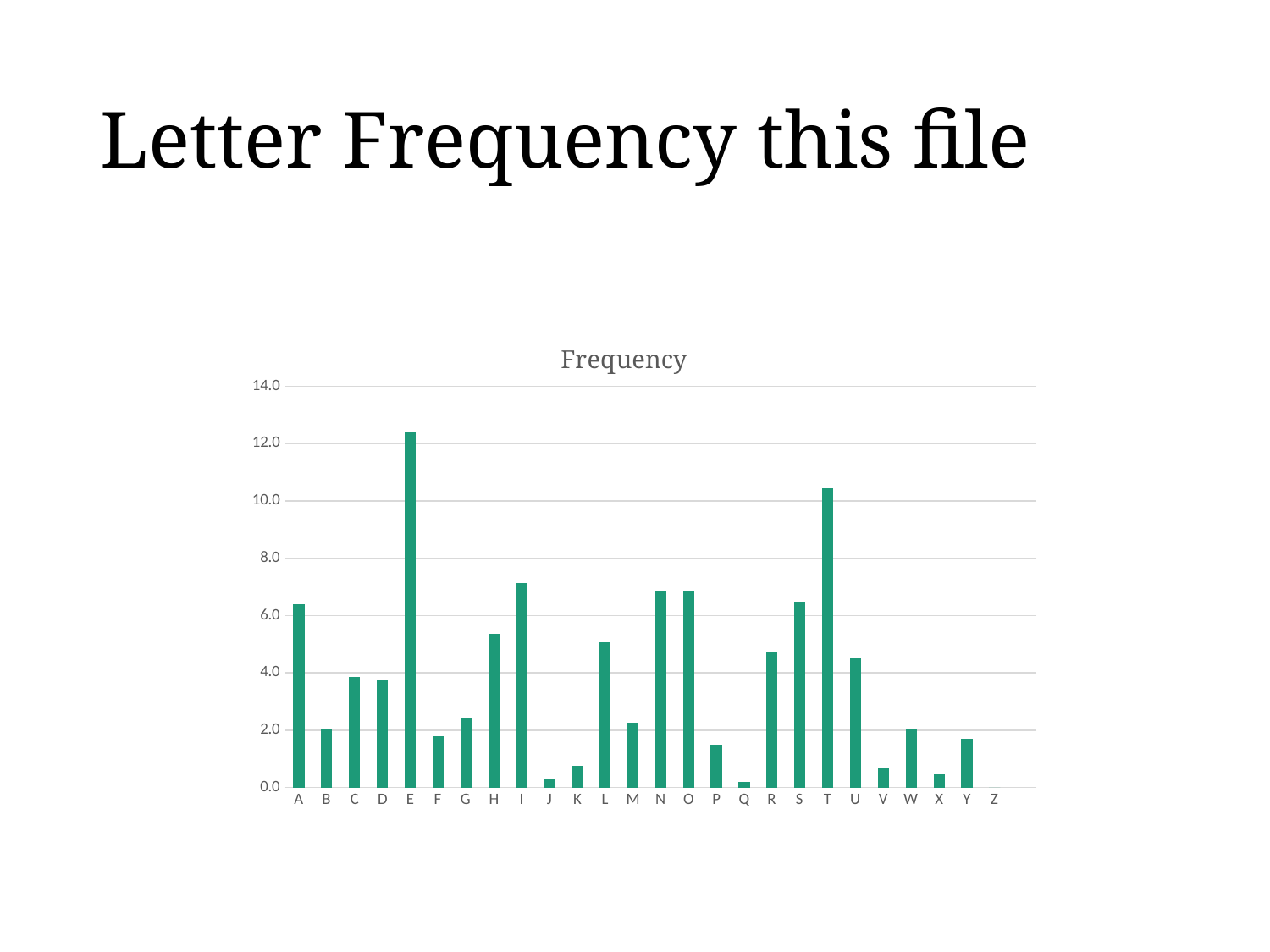
What kind of chart is shown on the slide? bar chart Which letter has the larger value, E or T? E Which letter has the lowest frequency in the chart? Z How many letter categories are shown on the x axis of the chart? 26 Is the value for H greater or less than 6.0? less Which letter has the highest frequency in the chart? E Which letter has the larger value, I or H? I Is the value for C greater or less than 4.0? less Is the value for L greater or less than 4.0? greater What is the title of the chart? Frequency